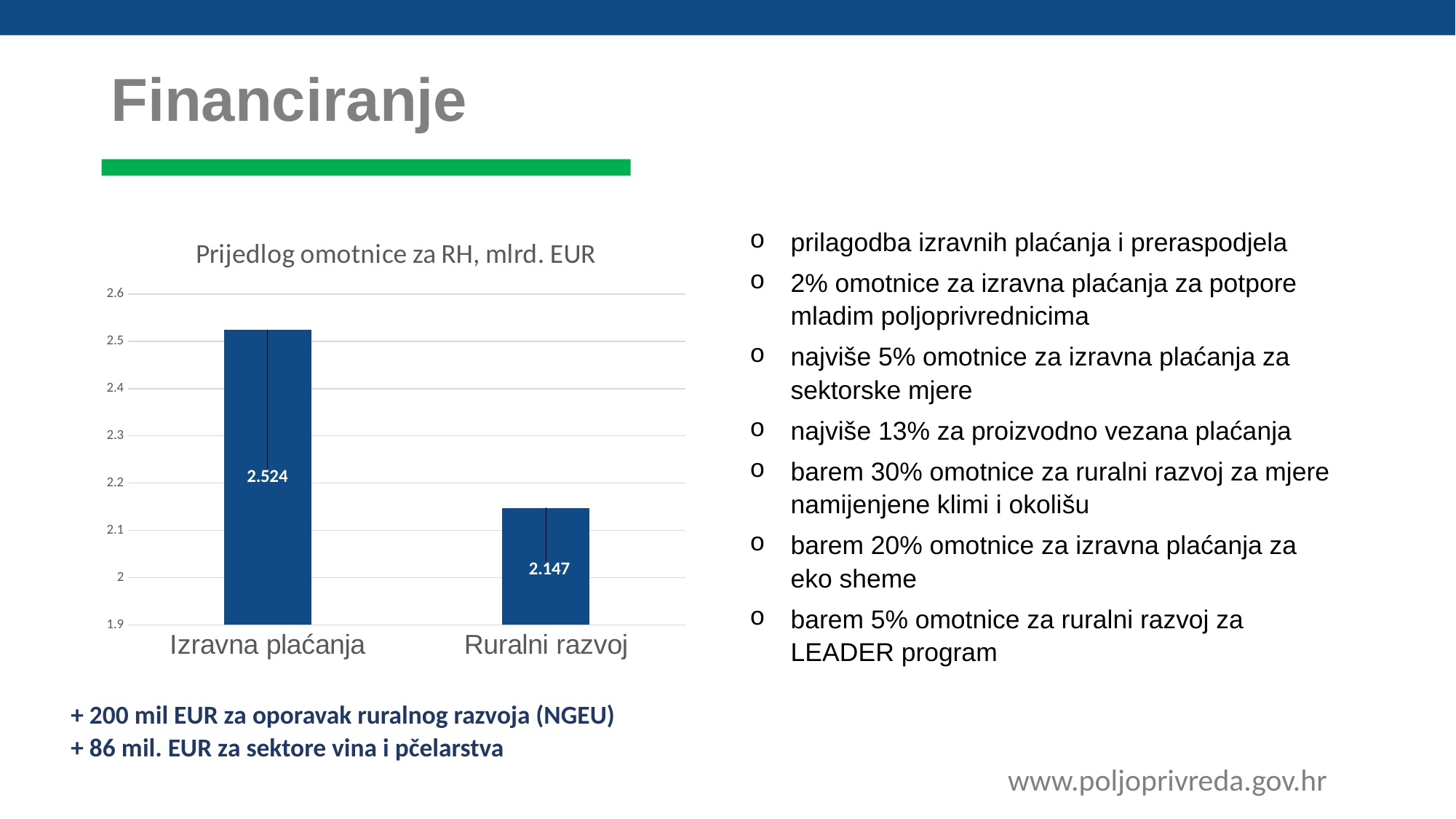
What is the highest value shown on the chart's vertical axis? 2.6 What is the title of the chart? Prijedlog omotnice za RH, mlrd. EUR How many categories are shown in the chart? 2 What is the value for Ruralni razvoj? 2.147 What is the difference between the values for Izravna plaćanja and Ruralni razvoj? 0.377 Which category has the lowest value? Ruralni razvoj What kind of chart is shown on the slide? bar chart Which category has the highest value? Izravna plaćanja Is the value for Izravna plaćanja greater or less than 2.5? greater Is the value for Ruralni razvoj greater or less than 2.2? less What is the value for Izravna plaćanja? 2.524 Which is larger, the value for Izravna plaćanja or the value for Ruralni razvoj? Izravna plaćanja